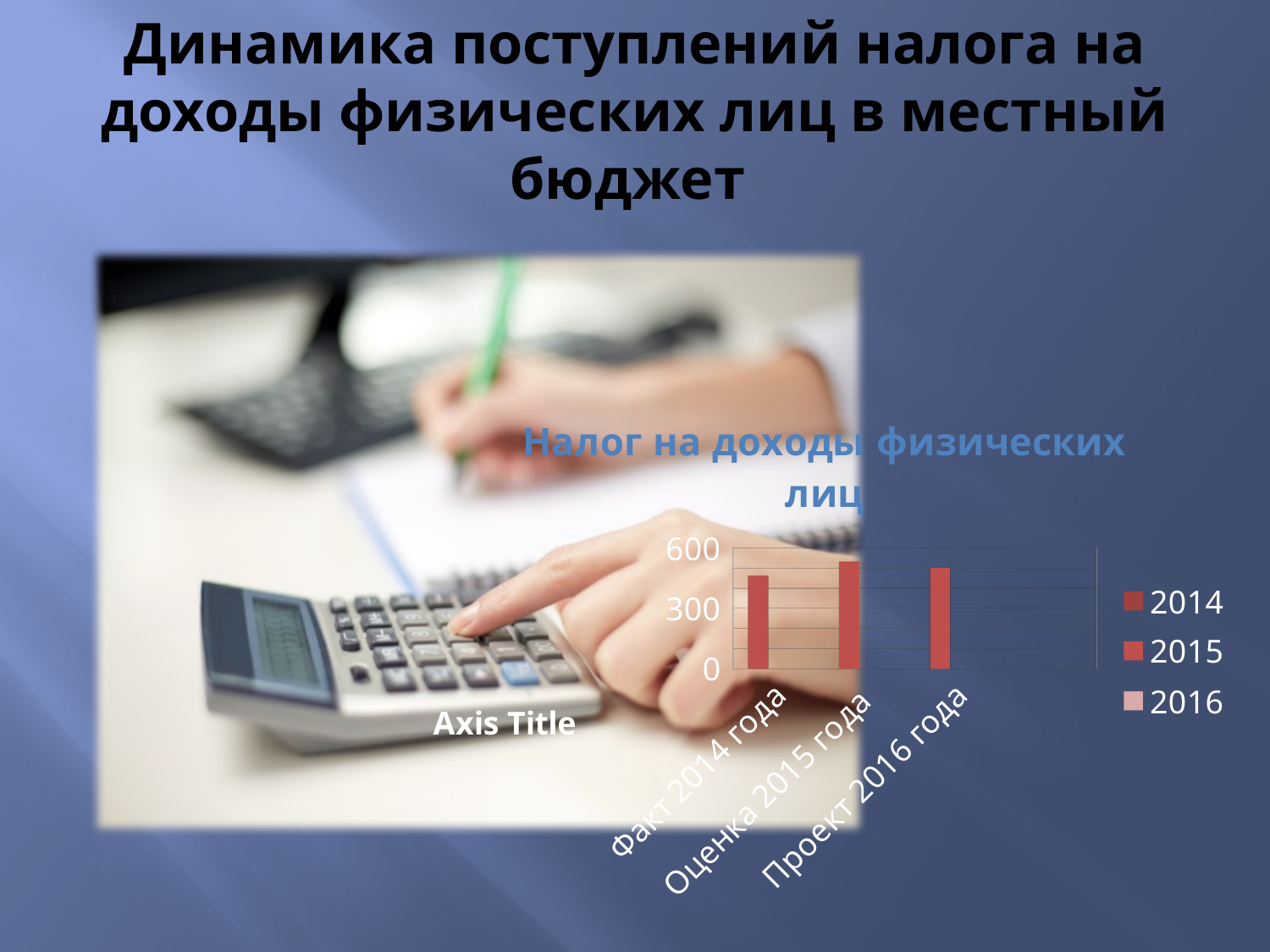
How many categories are shown on the x axis of the chart? 3 Which is larger, the value for Факт 2014 года or the value for Проект 2016 года? Проект 2016 года What is the title of the chart? Налог на доходы физических лиц Is the value for Проект 2016 года greater or less than 300? greater What kind of chart is shown on the slide? bar chart What are the entries listed in the chart legend? 2014, 2015, 2016 Which category has the tallest bar in the chart? Оценка 2015 года Which is larger, the value for Факт 2014 года or the value for Оценка 2015 года? Оценка 2015 года How many entries does the chart legend list? 3 Which category has the shortest bar in the chart? Факт 2014 года Is the value for Факт 2014 года greater or less than 300? greater Is the value for Оценка 2015 года greater or less than 600? less